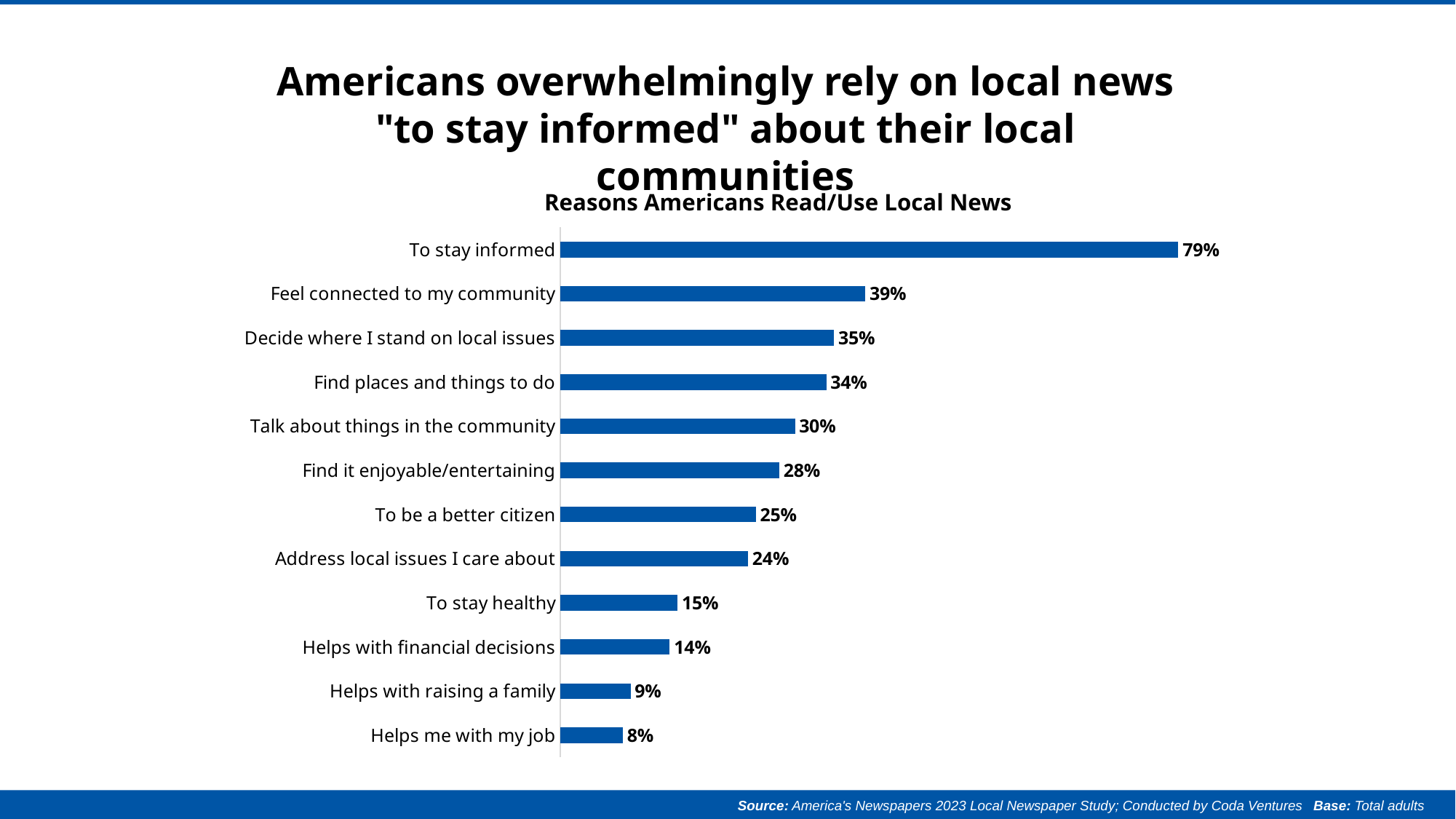
What is the difference between "To stay informed" and "Feel connected to my community"? 40 percentage points What is the title of the chart? Reasons Americans Read/Use Local News What kind of chart is shown on the slide? Bar chart What is the value for "Feel connected to my community"? 39% Do the values rise or fall going from the top bar to the bottom bar? Fall What percentage of Americans read/use local news to stay informed? 79% How many reasons are shown in the chart? 12 Which reason has the highest percentage? To stay informed Which is larger: "Find places and things to do" or "Talk about things in the community"? Find places and things to do What percentage cite "Helps with financial decisions" as a reason? 14% Which reason has the lowest percentage? Helps me with my job What is the difference between "To stay healthy" and "Helps with raising a family"? 6 percentage points